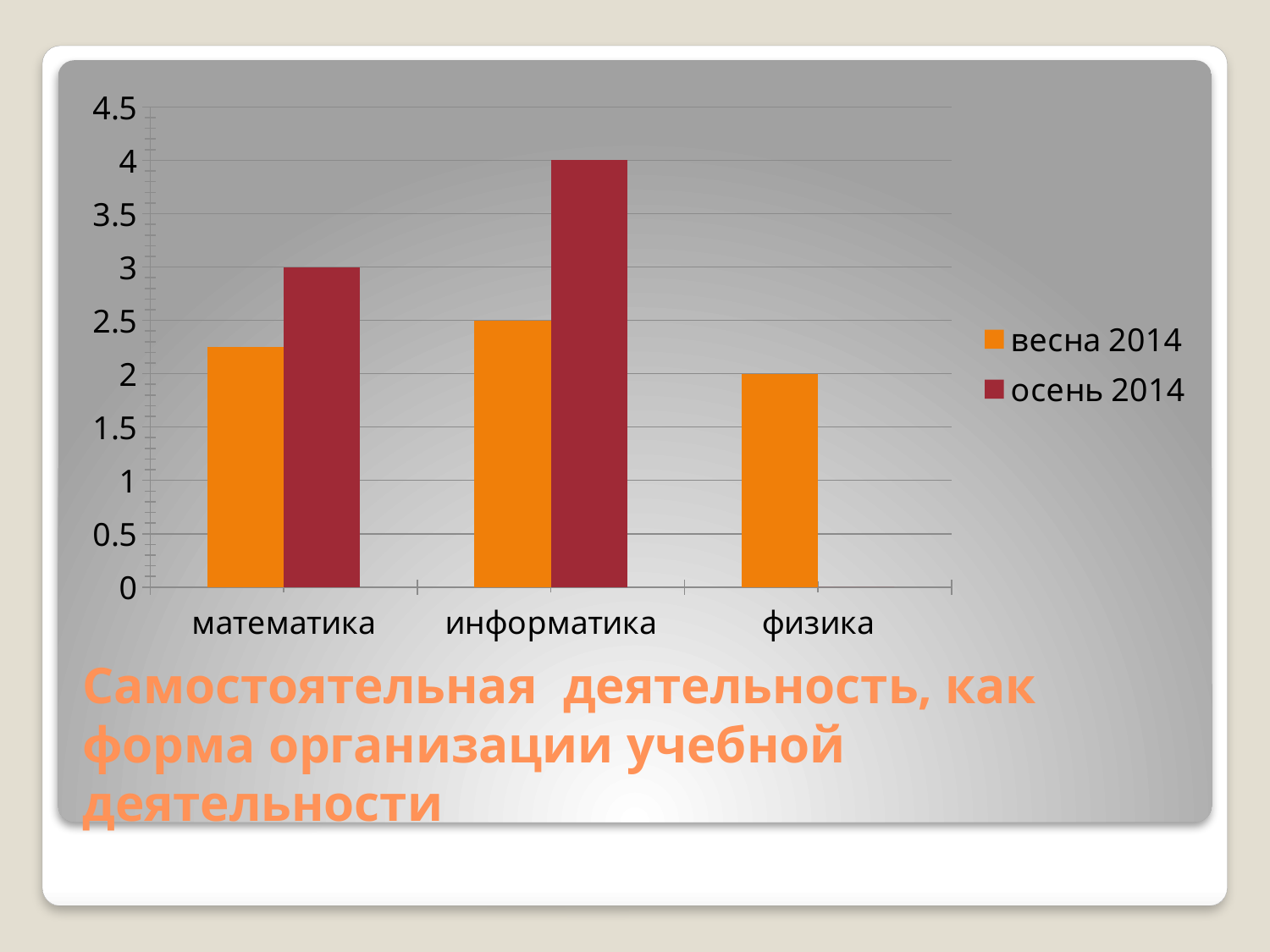
What is the value for информатика in the осень 2014 series? 4 How many categories are shown on the x axis? 3 Which category has the lowest value in the весна 2014 series? физика What is the difference between the осень 2014 values for информатика and математика? 1 What is the value for математика in the осень 2014 series? 3 What kind of chart is shown on the slide? bar chart For математика, which series has the larger value, весна 2014 or осень 2014? осень 2014 Which category has the highest value in the осень 2014 series? информатика Is the value for математика in the весна 2014 series greater or less than 2.5? less Which colour represents the весна 2014 series? orange How many series does the legend list? 2 What is the value for физика in the весна 2014 series? 2